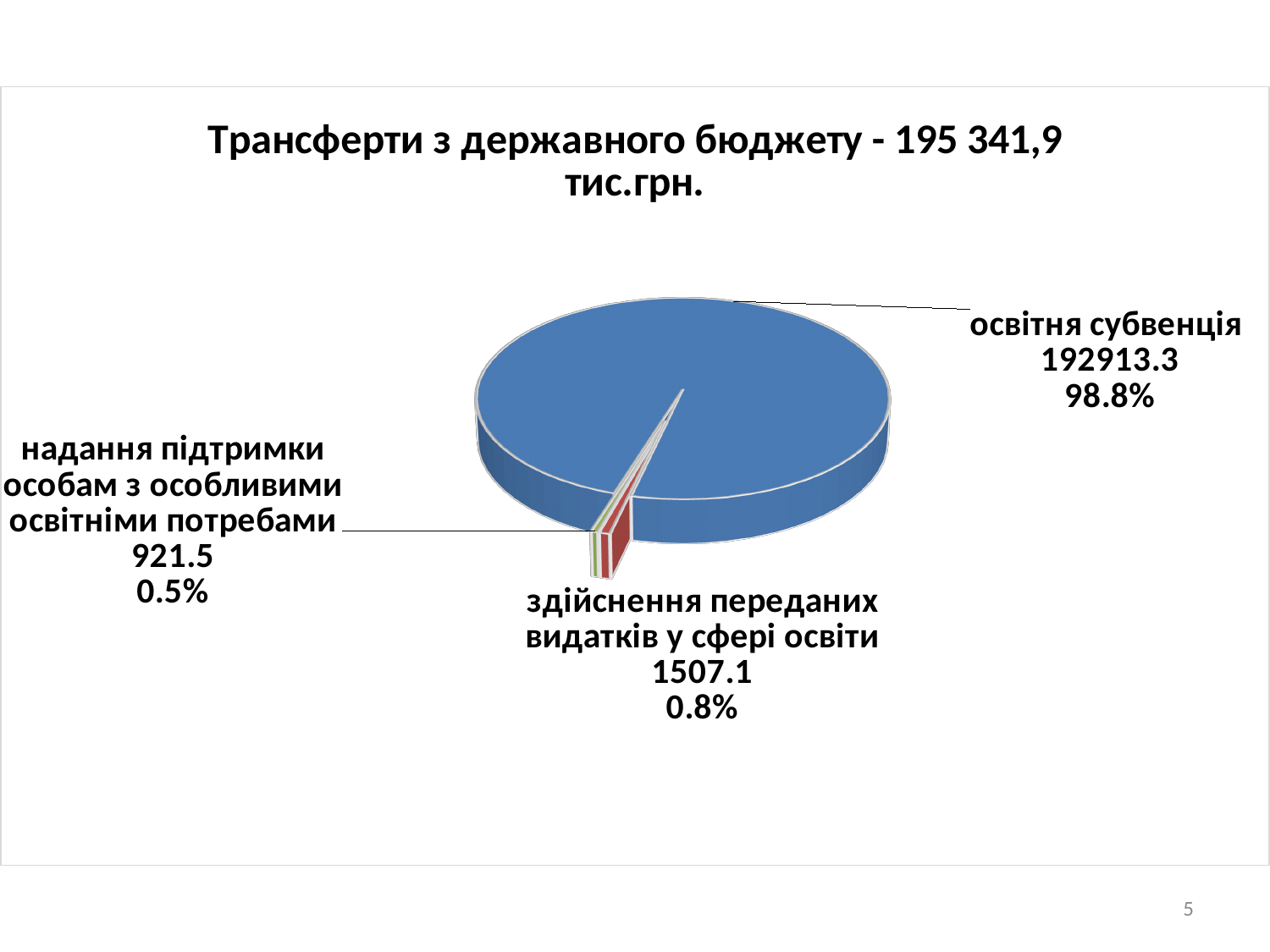
How many slices does the pie chart have? 3 Which slice is the largest? освітня субвенція What is the difference between the values for здійснення переданих видатків у сфері освіти and надання підтримки особам з особливими освітніми потребами? 585.6 What is the value for надання підтримки особам з особливими освітніми потребами? 921.5 What is the value for освітня субвенція? 192913.3 Which slice is the smallest? надання підтримки особам з особливими освітніми потребами What share of the pie does надання підтримки особам з особливими освітніми потребами represent? 0.5% What is the value for здійснення переданих видатків у сфері освіти? 1507.1 What share of the pie does освітня субвенція represent? 98.8% What is the title of the chart? Трансферти з державного бюджету - 195 341,9 тис.грн. What share of the pie does здійснення переданих видатків у сфері освіти represent? 0.8% What kind of chart is shown on the slide? pie chart